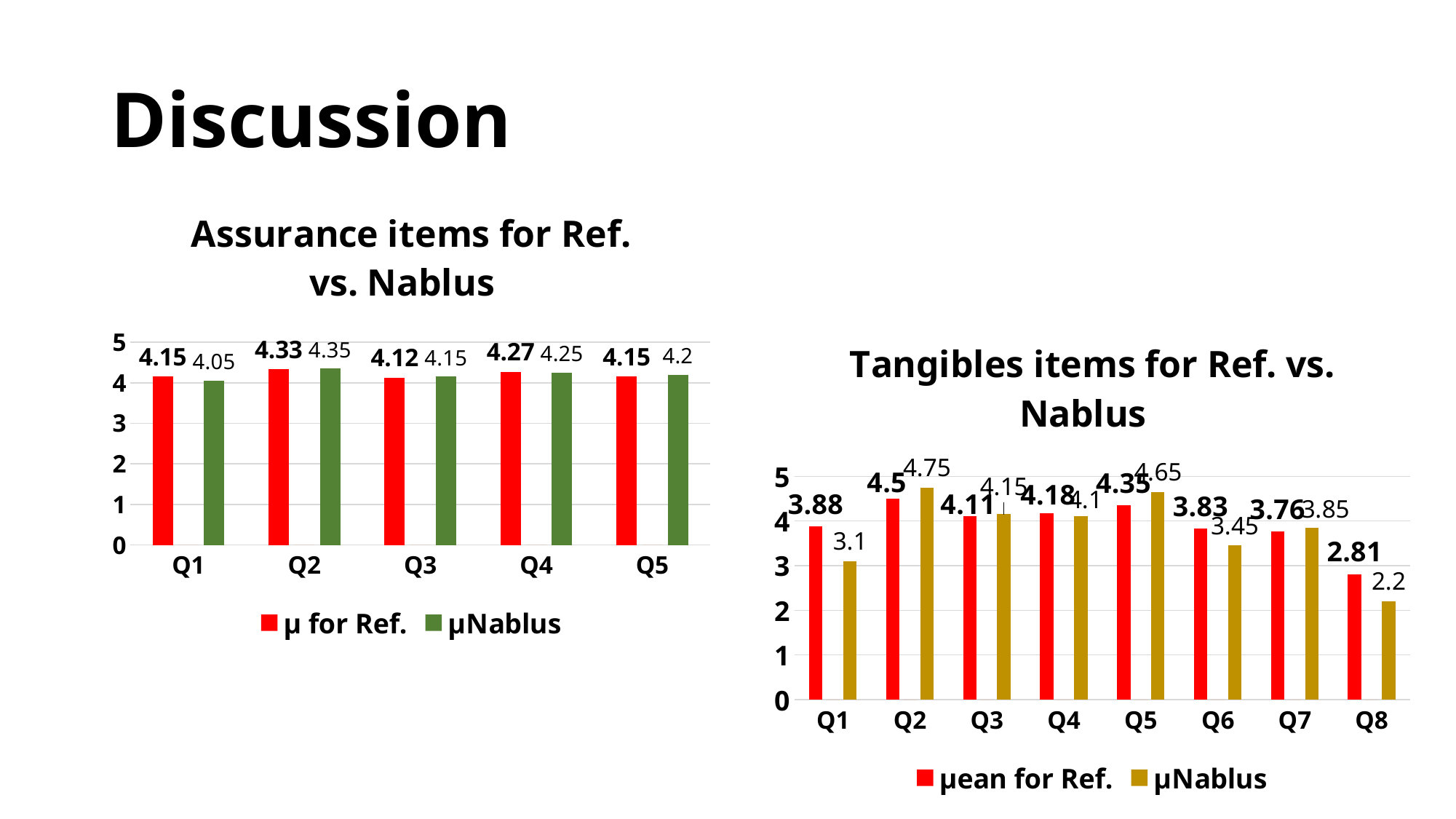
In the 'Tangibles items for Ref. vs. Nablus' chart, which question has the lowest μean for Ref. value? Q8 In the 'Assurance items for Ref. vs. Nablus' chart, how many questions are shown on the x axis? 5 In the 'Assurance items for Ref. vs. Nablus' chart, what is the difference between the μ for Ref. and μNablus values for Q1? 0.1 In the 'Tangibles items for Ref. vs. Nablus' chart, which question has the highest μNablus value? Q2 In the 'Tangibles items for Ref. vs. Nablus' chart, what is the μean for Ref. value for Q5? 4.35 How many series does the legend of the 'Tangibles items for Ref. vs. Nablus' chart list? 2 In the 'Tangibles items for Ref. vs. Nablus' chart, which is larger for Q1: the μean for Ref. value or the μNablus value? μean for Ref. In the 'Assurance items for Ref. vs. Nablus' chart, what is the μ for Ref. value for Q2? 4.33 In the 'Tangibles items for Ref. vs. Nablus' chart, what is the difference between the μNablus and μean for Ref. values for Q2? 0.25 In the 'Assurance items for Ref. vs. Nablus' chart, which question has the lowest μ for Ref. value? Q3 In the 'Assurance items for Ref. vs. Nablus' chart, what is the μNablus value for Q1? 4.05 In the 'Tangibles items for Ref. vs. Nablus' chart, what is the μNablus value for Q8? 2.2